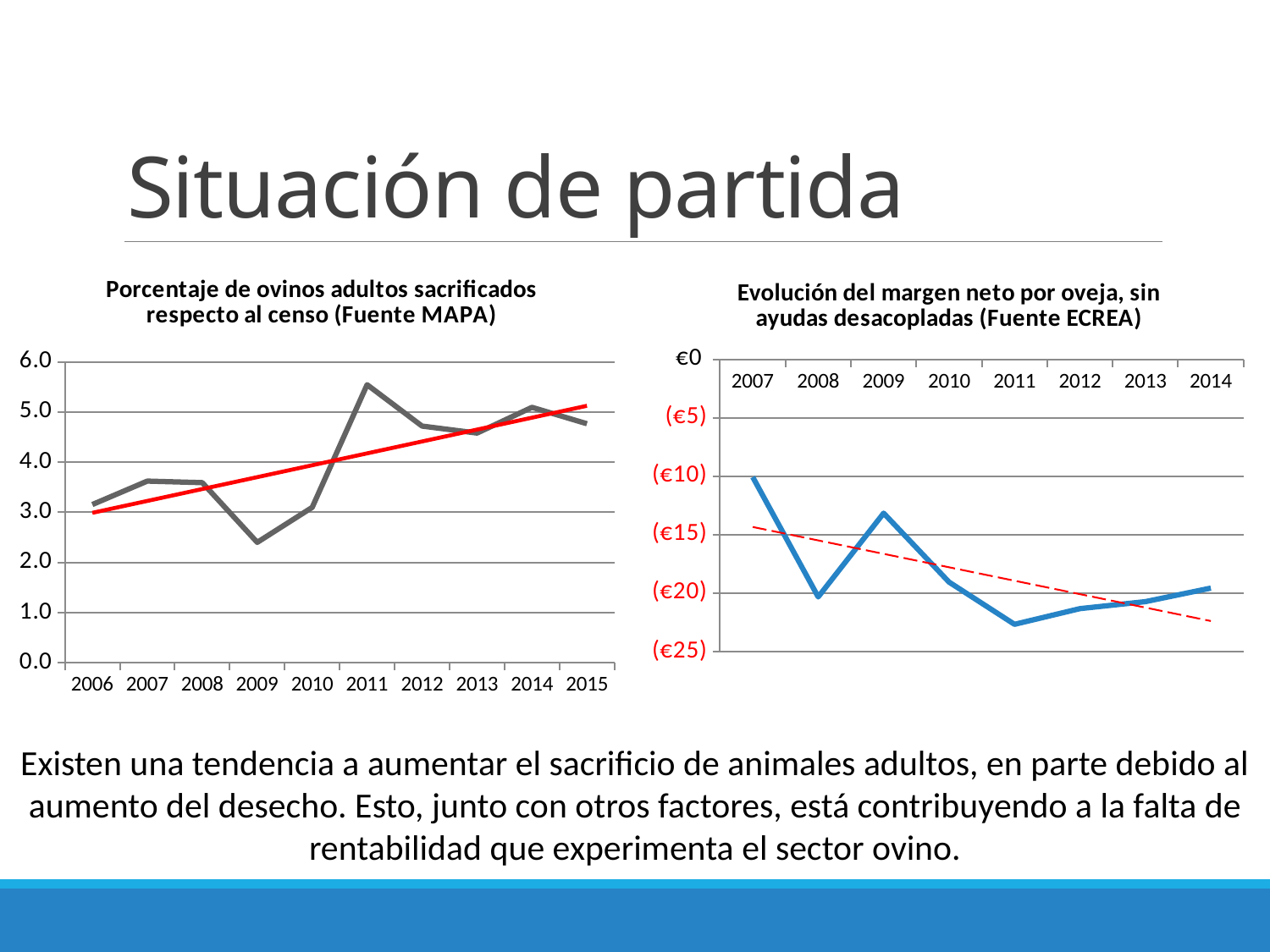
In the right chart, 'Evolución del margen neto por oveja', which year has the lowest value? 2011 In the left chart, 'Porcentaje de ovinos adultos sacrificados', which year has the highest value? 2011 In the right chart, 'Evolución del margen neto por oveja', does the dashed trend line rise or fall from 2007 to 2014? falls In the left chart, 'Porcentaje de ovinos adultos sacrificados', which year has the lowest value? 2009 In the left chart, 'Porcentaje de ovinos adultos sacrificados', is the value for 2011 greater or less than 5.0? greater In the left chart, 'Porcentaje de ovinos adultos sacrificados', is the value for 2009 greater or less than 3.0? less In the left chart, 'Porcentaje de ovinos adultos sacrificados', does the red trend line rise or fall from 2006 to 2015? rises In the right chart, 'Evolución del margen neto por oveja', which year has the highest (least negative) value? 2007 In the left chart, 'Porcentaje de ovinos adultos sacrificados', how many years are shown on the x axis? 10 In the right chart, 'Evolución del margen neto por oveja', how many years are shown on the x axis? 8 What kind of chart is the right chart, 'Evolución del margen neto por oveja'? line chart What kind of chart is the left chart, 'Porcentaje de ovinos adultos sacrificados respecto al censo'? line chart